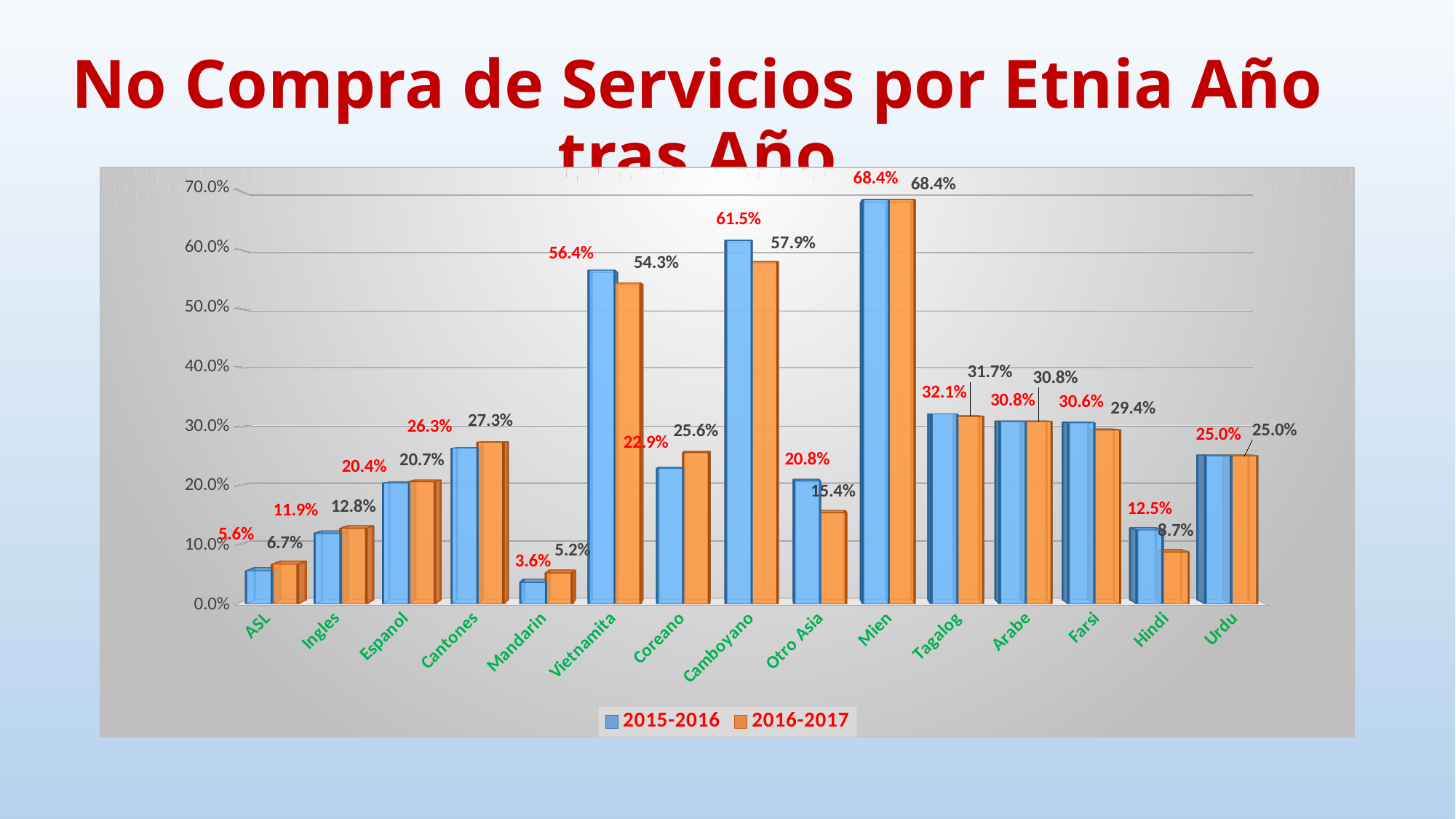
What kind of chart is shown on the slide? bar chart How many series does the legend list? 2 How many categories are shown on the x axis? 15 Is the 2016-2017 value for Cantones greater or less than 30.0%? less What is the difference between the 2015-2016 and 2016-2017 values for Camboyano? 3.6% What is the 2016-2017 value for Otro Asia? 15.4% What is the 2015-2016 value for Vietnamita? 56.4% Which category has the highest 2015-2016 value? Mien Which series is shown in orange in the legend? 2016-2017 What is the 2016-2017 value for Hindi? 8.7% Which is larger for Coreano, the 2015-2016 value or the 2016-2017 value? 2016-2017 Which category has the lowest 2016-2017 value? Mandarin